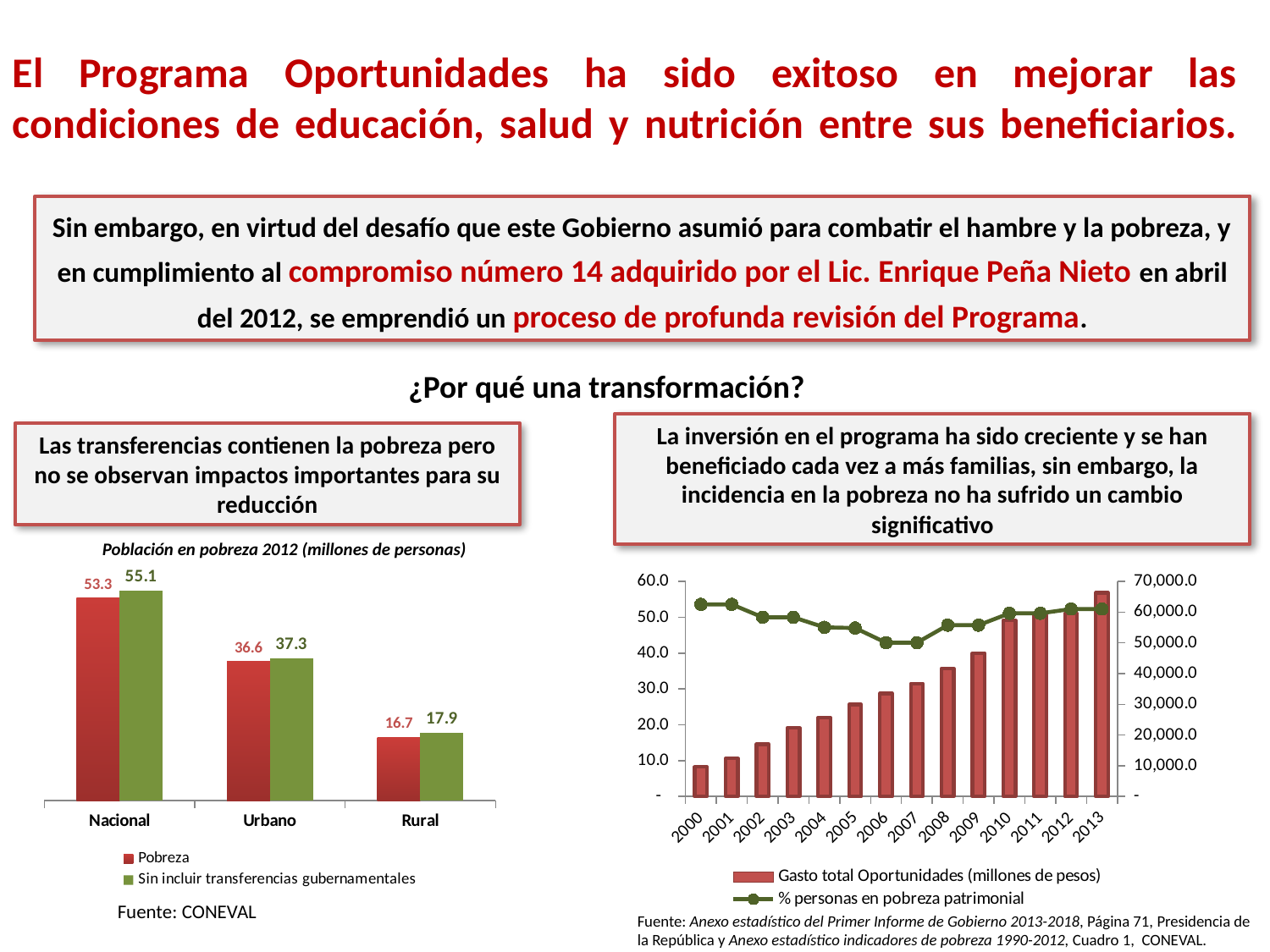
In the chart 'Población en pobreza 2012 (millones de personas)', what is the value for Nacional in the 'Pobreza' series? 53.3 In the chart 'Población en pobreza 2012 (millones de personas)', how many series does the legend list? 2 In the chart 'Población en pobreza 2012 (millones de personas)', which category has the lowest 'Pobreza' value? Rural In the chart on the right of the slide, is the '% personas en pobreza patrimonial' value for 2006 greater or less than 50.0? less In the chart on the right of the slide, do the 'Gasto total Oportunidades' bars rise or fall from 2000 to 2013? rise In the chart 'Población en pobreza 2012 (millones de personas)', what is the value for Urbano in the 'Pobreza' series? 36.6 In the chart 'Población en pobreza 2012 (millones de personas)', what is the value for Rural in the 'Sin incluir transferencias gubernamentales' series? 17.9 In the chart 'Población en pobreza 2012 (millones de personas)', what is the difference between the two series for Nacional? 1.8 In the chart on the right of the slide, how many years are shown on the x axis? 14 In the chart on the right of the slide, which series is drawn as a line with markers? % personas en pobreza patrimonial In the chart 'Población en pobreza 2012 (millones de personas)', how many categories are shown on the x axis? 3